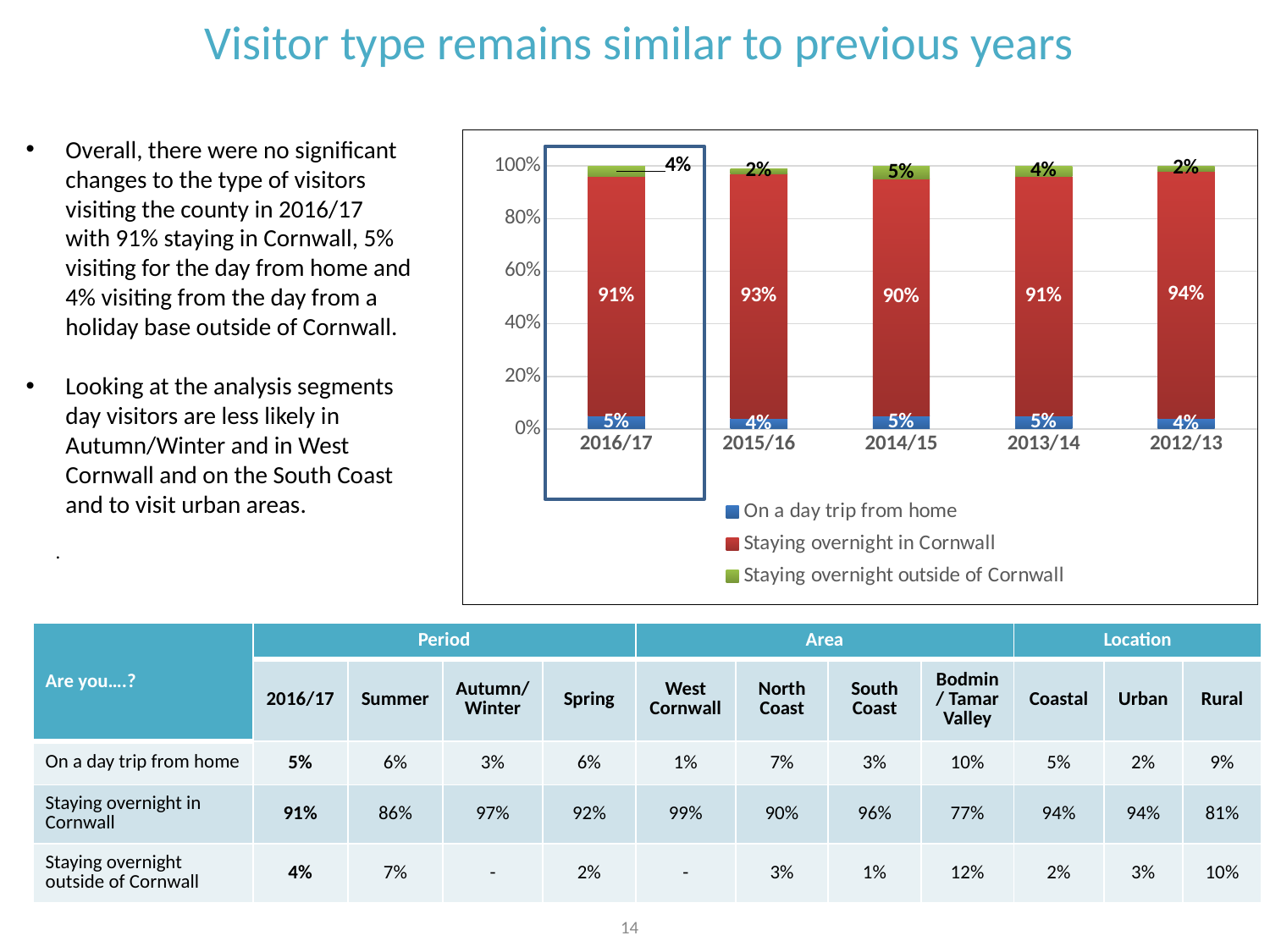
What is the difference between the 'Staying overnight in Cornwall' values for 2012/13 and 2014/15? 4% Which year has the lowest value for 'Staying overnight in Cornwall'? 2014/15 Which series is shown in red in the chart? Staying overnight in Cornwall How many years are shown on the x axis of the chart? 5 How many series does the chart legend list? 3 What kind of chart is shown on the slide? Stacked bar chart Is the 'Staying overnight outside of Cornwall' value larger in 2016/17 or in 2015/16? 2016/17 What is the value for 'Staying overnight outside of Cornwall' in 2014/15? 5% What is the value for 'On a day trip from home' in 2015/16? 4% Which year has the highest value for 'Staying overnight in Cornwall'? 2012/13 What is the value for 'Staying overnight in Cornwall' in 2012/13? 94% What percentage of visitors in 2016/17 were staying overnight in Cornwall? 91%